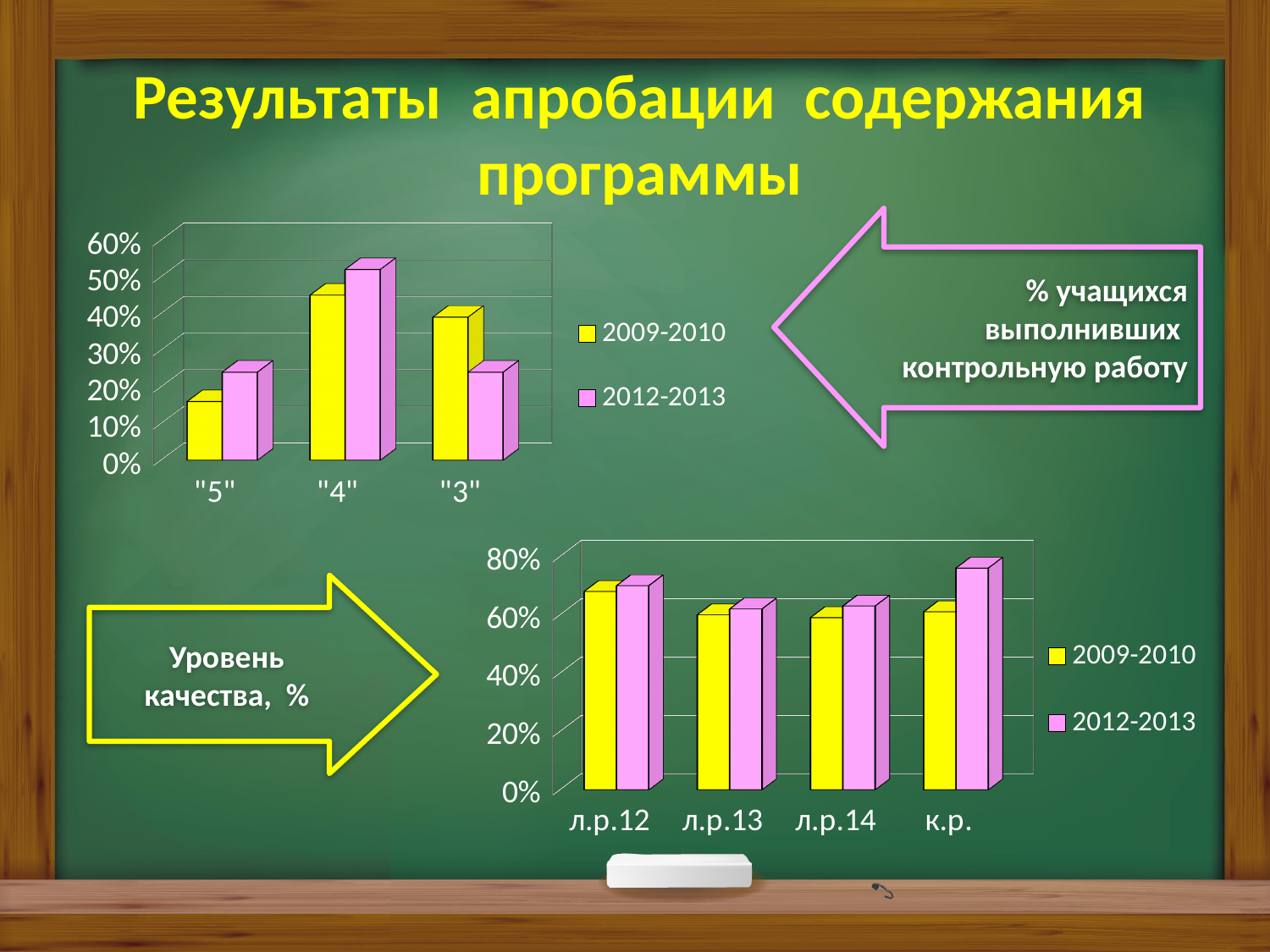
In the bottom chart, is the 2012-2013 value for к.р. greater or less than 60%? greater In the bottom chart, which category has the highest value for the 2012-2013 series? к.р. In the top-left chart, is the 2009-2010 value for "5" greater or less than 20%? less In the top-left chart, which category has the highest value for the 2012-2013 series? "4" In the top-left chart, which category has the lowest value for the 2009-2010 series? "5" In the bottom chart, which category has the highest value for the 2009-2010 series? л.р.12 How many categories does the bottom chart show? 4 What kind of chart is the top-left chart on the slide? bar chart How many categories does the top-left chart show? 3 In the top-left chart, for category "3", which series has the larger value, 2009-2010 or 2012-2013? 2009-2010 In the top-left chart, is the 2012-2013 value for "4" greater or less than 40%? greater How many series does the legend of the bottom chart list? 2